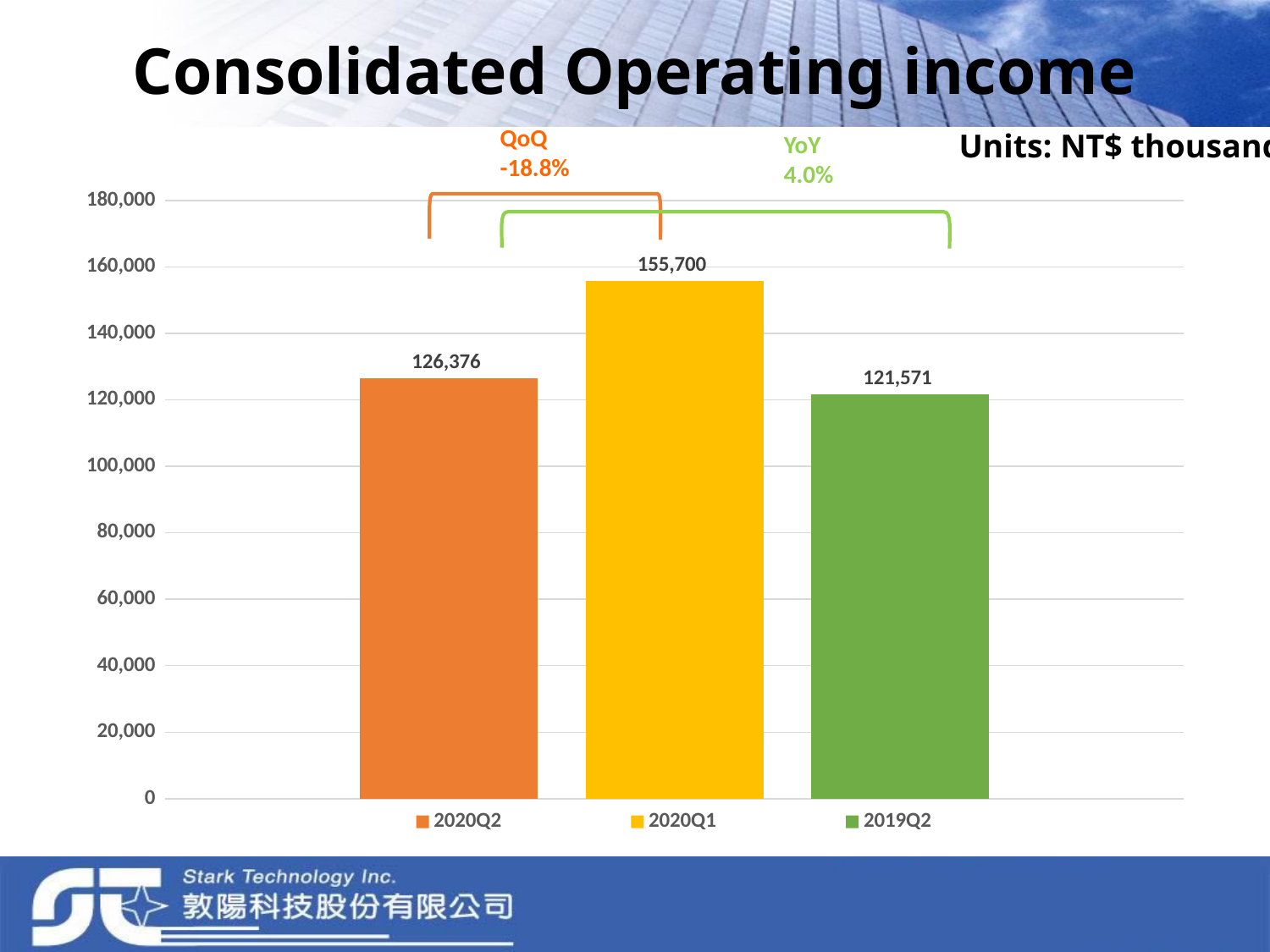
Which period has the highest consolidated operating income? 2020Q1 What kind of chart is shown on the slide? Bar chart What QoQ percentage change is shown on the chart? -18.8% Is the value for 2020Q1 greater or less than 140,000? greater What is the difference between the operating income for 2020Q1 and 2020Q2? 29,324 What is the difference between the operating income for 2020Q2 and 2019Q2? 4,805 What is the consolidated operating income for 2019Q2? 121,571 Which is larger, the operating income for 2020Q2 or 2019Q2? 2020Q2 How many periods are shown in the chart? 3 What is the consolidated operating income for 2020Q2? 126,376 Which period has the lowest consolidated operating income? 2019Q2 What is the consolidated operating income for 2020Q1? 155,700